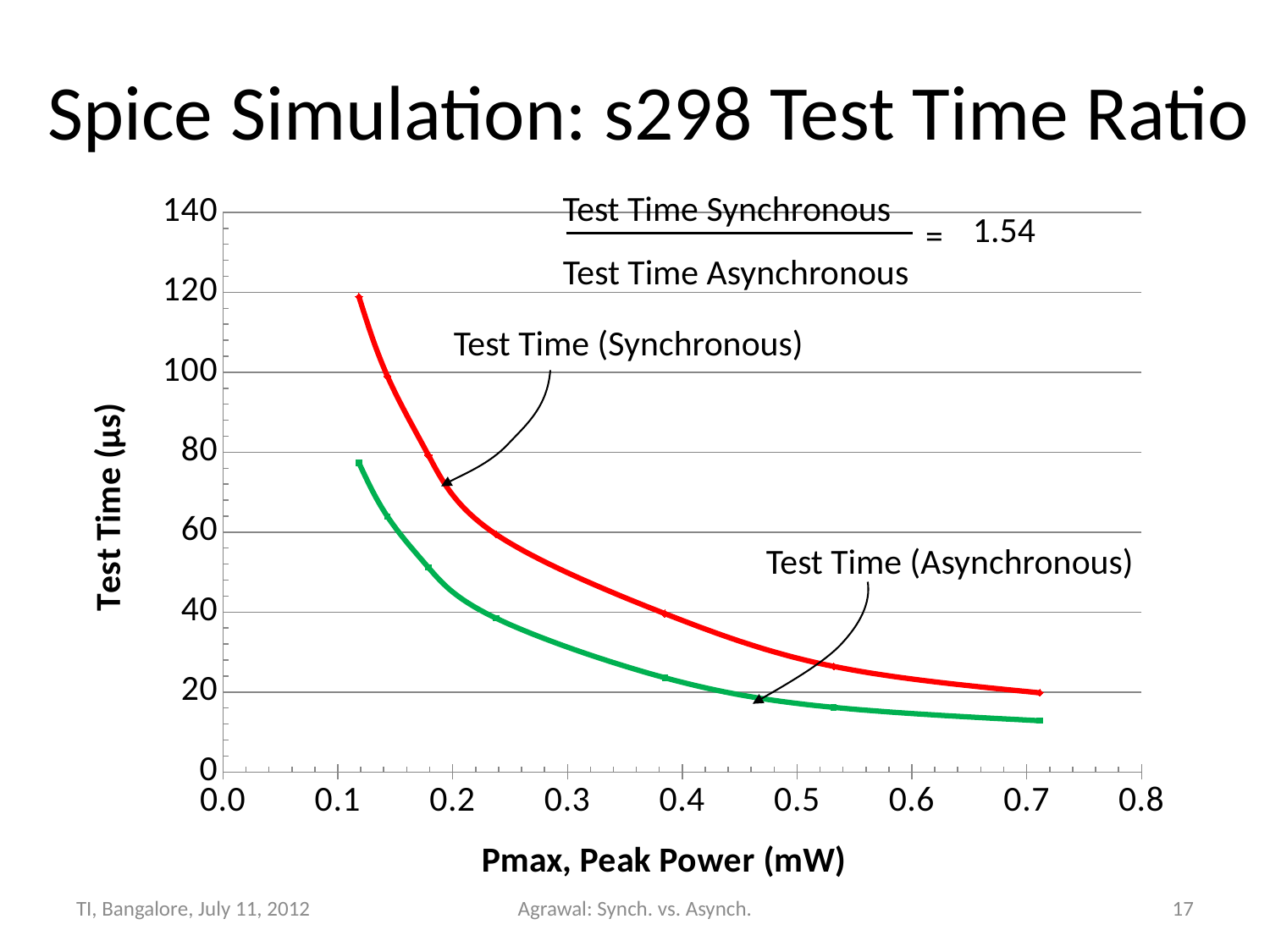
What kind of chart is shown on the slide? line chart How many data series (curves) are plotted on the chart? 2 Which curve is higher at every plotted Pmax value, Test Time (Synchronous) or Test Time (Asynchronous)? Test Time (Synchronous) Is the highest value of the Test Time (Asynchronous) curve greater or less than 100 µs? less What is the ratio of Test Time Synchronous to Test Time Asynchronous stated on the slide? 1.54 Does the Test Time (Asynchronous) curve rise or fall as Pmax increases? fall What is the label of the x axis of the chart? Pmax, Peak Power (mW) Does the Test Time (Synchronous) curve rise or fall as Pmax increases? fall At Pmax = 0.7 mW, is the Test Time (Asynchronous) value greater or less than 20 µs? less At Pmax = 0.3 mW, is the Test Time (Synchronous) value greater or less than 40 µs? greater